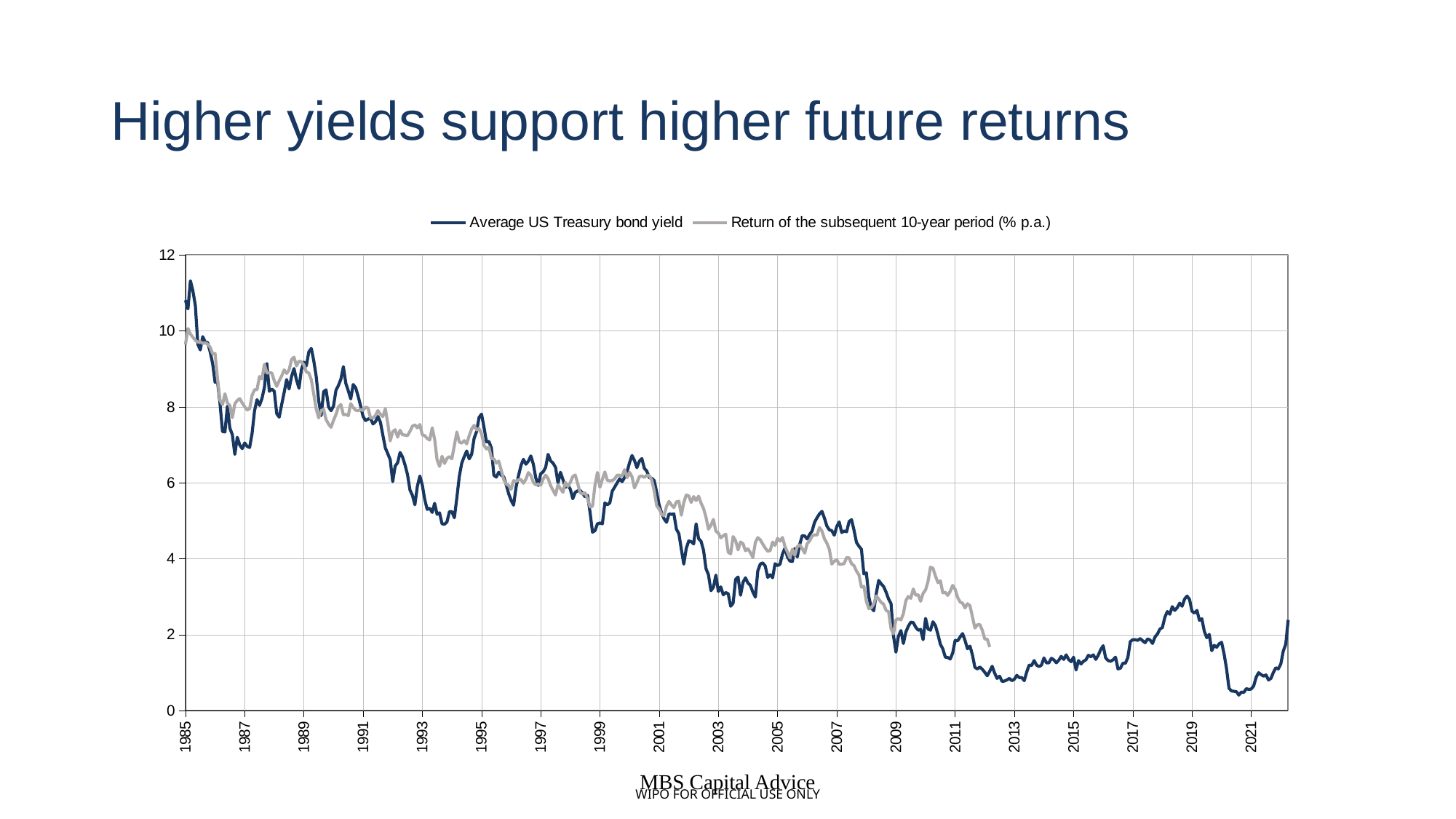
Is the Average US Treasury bond yield at the start of 1985 greater or less than 10? greater What are the two series named in the legend? Average US Treasury bond yield; Return of the subsequent 10-year period (% p.a.) What is the title of the slide containing the chart? Higher yields support higher future returns Does the Return of the subsequent 10-year period (% p.a.) generally rise or fall from 1985 to 2011? fall In 2003, which series has the higher value? Return of the subsequent 10-year period (% p.a.) How many series does the legend list? 2 Does the Average US Treasury bond yield generally rise or fall from 1985 to 2021? fall Is the Average US Treasury bond yield in 1993 greater or less than 8? less Is the Average US Treasury bond yield in 2019 greater or less than 4? less What kind of chart is shown on the slide? line chart